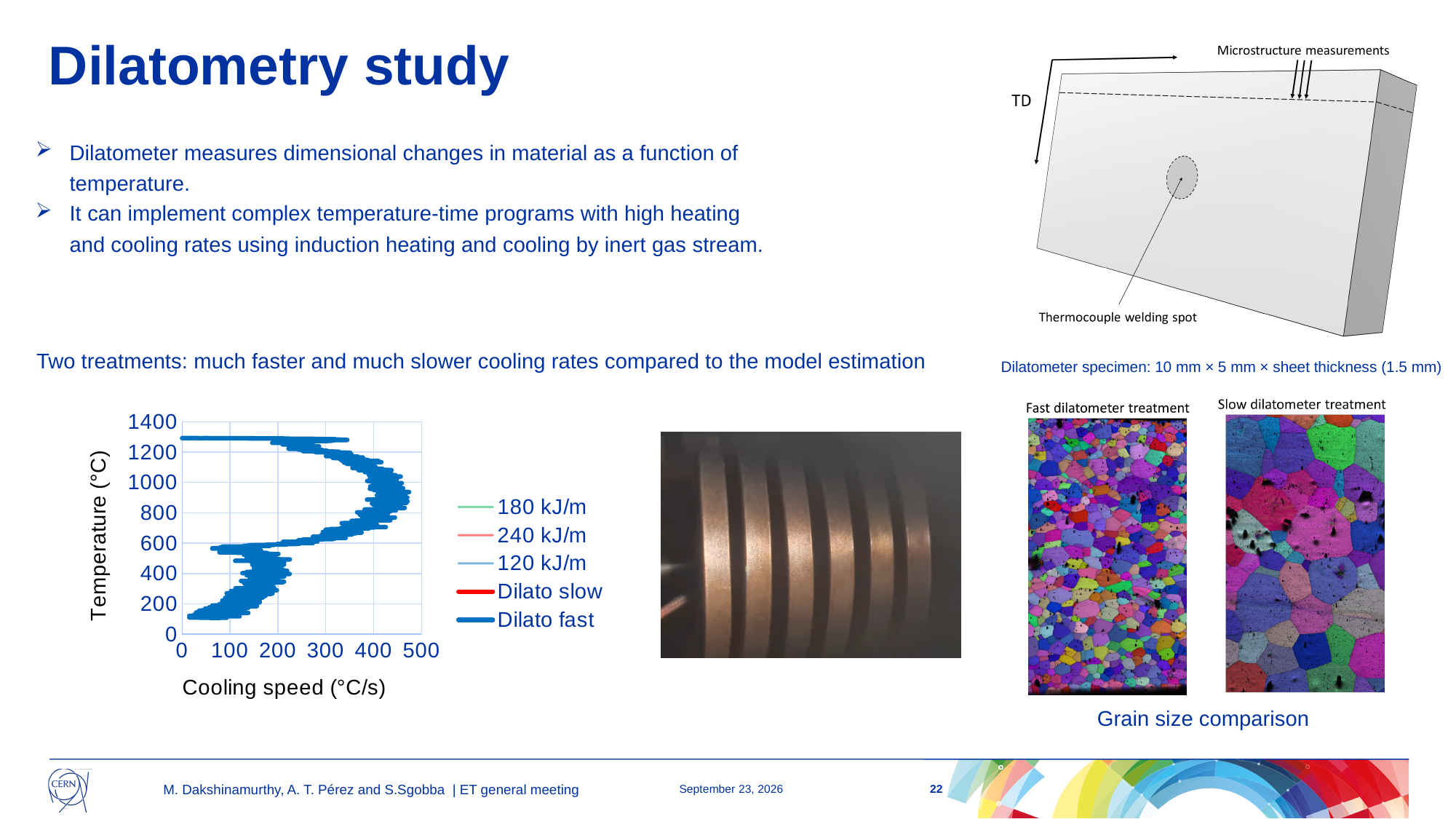
Which legend entry is drawn in red in the chart? Dilato slow Is the maximum cooling speed reached by the Dilato fast curve greater or less than 400? greater How many series does the legend of the Temperature vs Cooling speed chart list? 5 What is the highest tick value shown on the y axis of the chart? 1400 Is the maximum cooling speed reached by the Dilato fast curve greater or less than 500? less Is the temperature at which the Dilato fast curve reaches its highest cooling speed greater or less than 600? greater What kind of chart is shown at the bottom left of the slide? line chart What is the label of the x axis of the chart? Cooling speed (°C/s) What is the label of the y axis of the chart? Temperature (°C) What is the highest tick value shown on the x axis of the chart? 500 Which legend entry is drawn as a thick blue line in the chart? Dilato fast